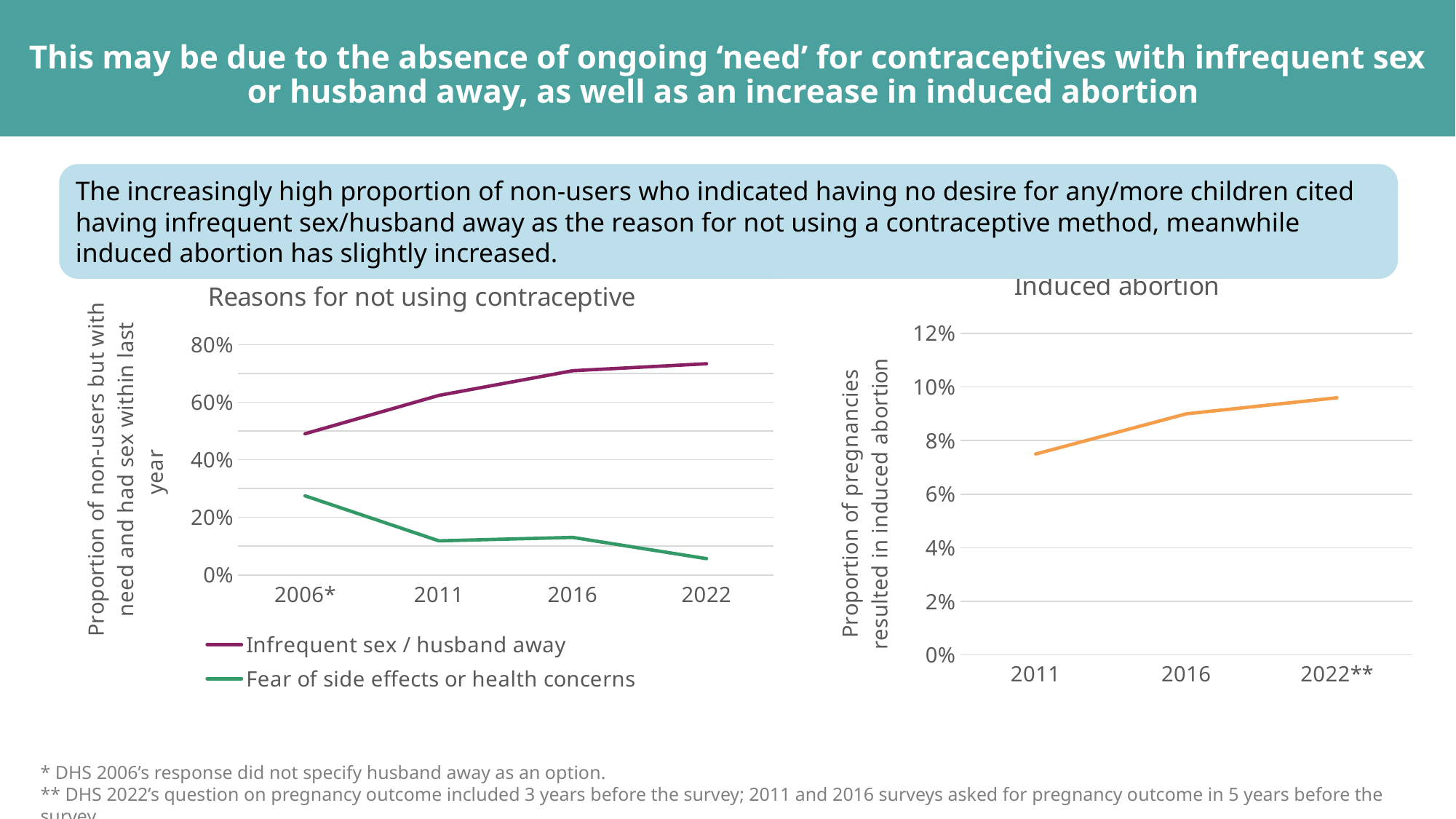
In the 'Induced abortion' chart, is the value for 2022** greater or less than 8%? greater In the 'Reasons for not using contraceptive' chart, which series has the higher value in 2016? Infrequent sex / husband away How many years are shown on the x axis of the 'Induced abortion' chart? 3 In the 'Reasons for not using contraceptive' chart, is the value for 'Fear of side effects or health concerns' in 2022 greater or less than 20%? less In the 'Reasons for not using contraceptive' chart, in which year is 'Fear of side effects or health concerns' highest? 2006* In the 'Reasons for not using contraceptive' chart, is the value for 'Infrequent sex / husband away' in 2022 greater or less than 60%? greater In the 'Induced abortion' chart, does the line rise or fall from 2011 to 2022**? rise How many years are shown on the x axis of the 'Reasons for not using contraceptive' chart? 4 In the 'Reasons for not using contraceptive' chart, does the 'Fear of side effects or health concerns' line rise or fall from 2006* to 2022? fall How many series does the legend of the 'Reasons for not using contraceptive' chart list? 2 In the 'Reasons for not using contraceptive' chart, does the 'Infrequent sex / husband away' line rise or fall from 2006* to 2022? rise What type of chart is the 'Reasons for not using contraceptive' chart? line chart